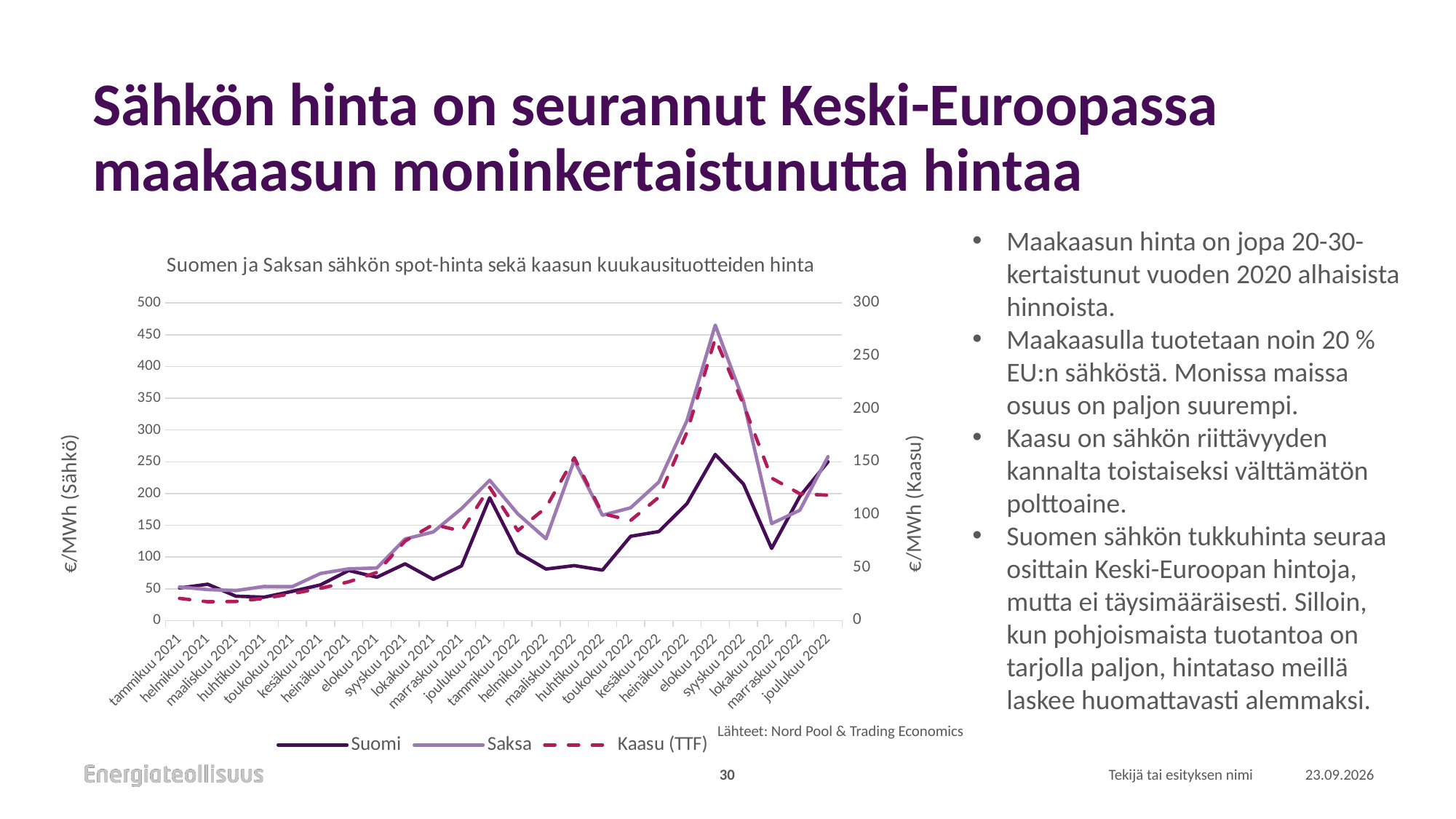
Is the value for Suomi in lokakuu 2022 greater or less than 150 €/MWh? less How many months are plotted along the x axis of the chart? 24 In which month does the Saksa series reach its highest value? elokuu 2022 Which series in the legend is drawn with a dashed line? Kaasu (TTF) Which series has the larger value in elokuu 2022, Suomi or Saksa? Saksa What kind of chart is shown on the slide? line chart What is the title of the chart? Suomen ja Saksan sähkön spot-hinta sekä kaasun kuukausituotteiden hinta Is the value for Saksa in elokuu 2022 greater or less than 400 €/MWh? greater Is the value for Suomi in elokuu 2022 greater or less than 200 €/MWh? greater How many series does the chart legend list? 3 Do the Saksa values generally rise or fall from tammikuu 2021 to elokuu 2022? rise